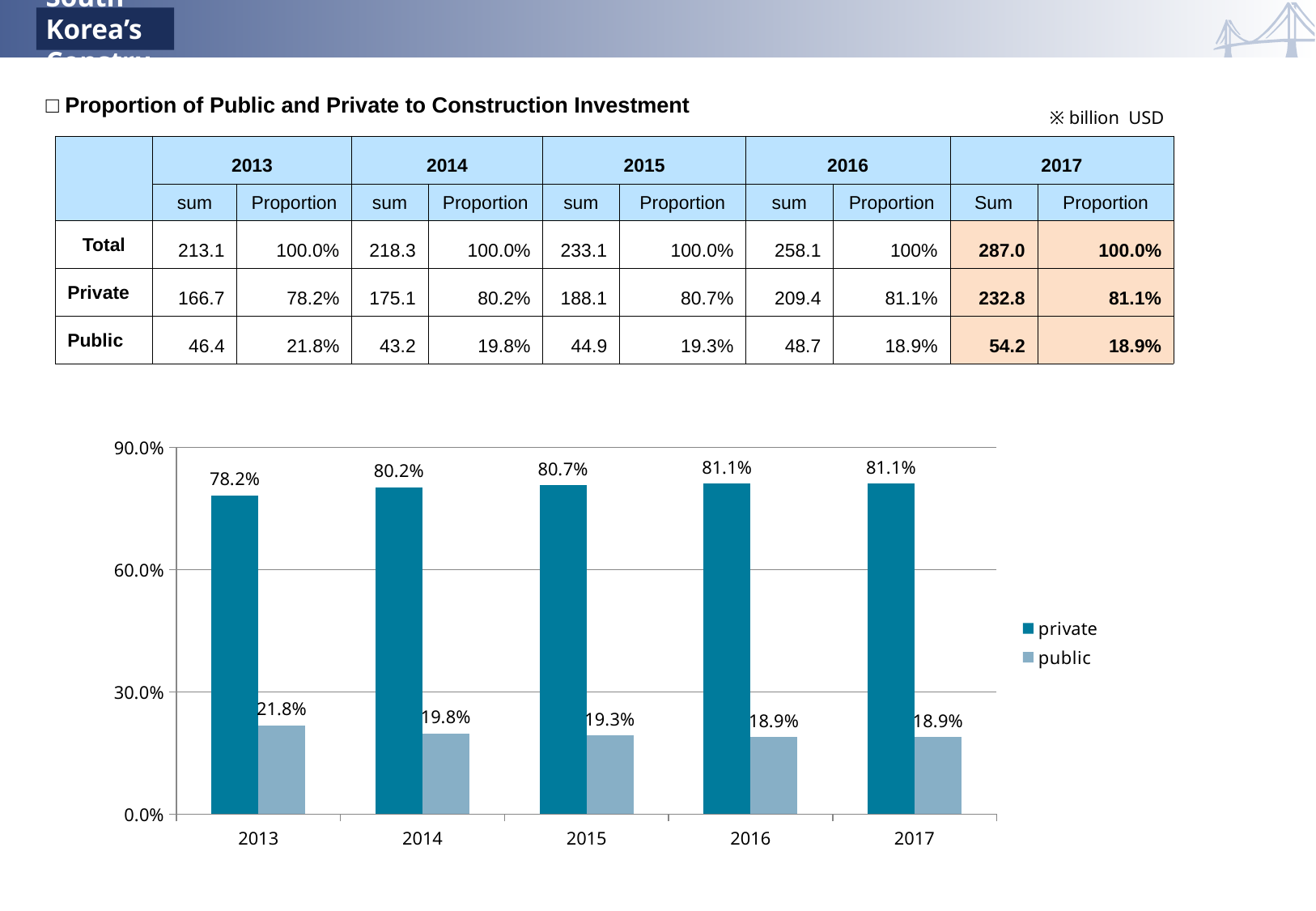
How many series does the chart legend list? 2 How many years are shown on the x axis of the chart? 5 What kind of chart is shown on the slide? bar chart Does the public proportion rise or fall from 2013 to 2017 in the chart? fall In which year is the public proportion highest in the chart? 2013 What is the private proportion shown for 2017 in the chart? 81.1% Is the public proportion for 2017 greater or less than 30.0%? less What is the public proportion shown for 2015 in the chart? 19.3% What is the private proportion shown for 2013 in the chart? 78.2% What is the difference between the private and public proportions in 2014? 60.4% In which year is the private proportion lowest in the chart? 2013 Which is larger in 2016, the private proportion or the public proportion? private